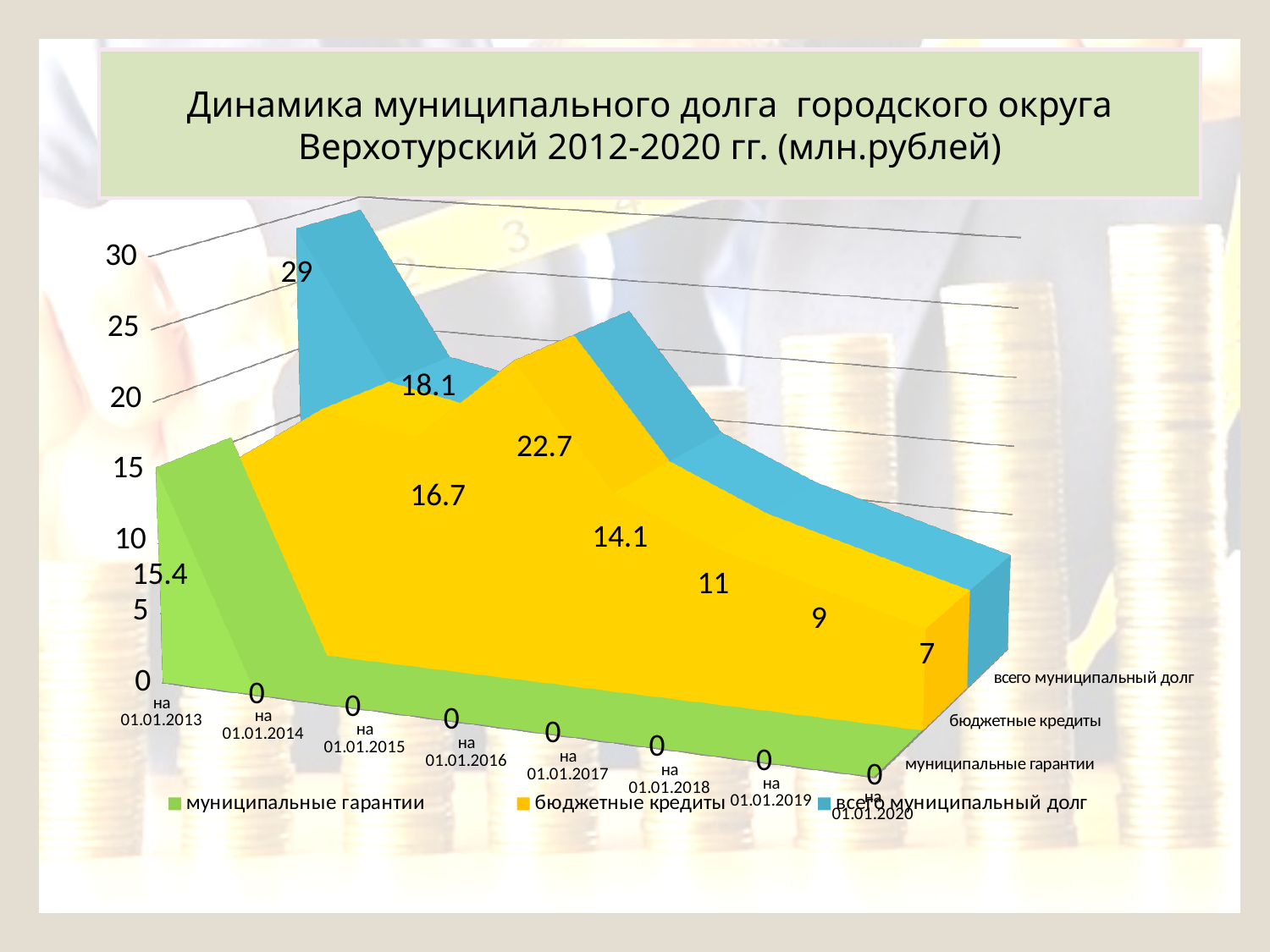
What is the value for бюджетные кредиты на 01.01.2020? 7 What is the value for бюджетные кредиты на 01.01.2019? 9 What is the value for муниципальные гарантии на 01.01.2013? 15.4 How many series does the legend list? 3 What kind of chart is shown on the slide? area chart What is the value for бюджетные кредиты на 01.01.2017? 14.1 Which is larger: бюджетные кредиты на 01.01.2018 or на 01.01.2019? на 01.01.2018 How many dates are shown along the x axis? 8 What is the value for муниципальные гарантии на 01.01.2020? 0 What is the title of the chart? Динамика муниципального долга городского округа Верхотурский 2012-2020 гг. (млн.рублей) What is the difference between бюджетные кредиты на 01.01.2018 and на 01.01.2020? 4 Do the values for бюджетные кредиты rise or fall from 01.01.2017 to 01.01.2020? fall